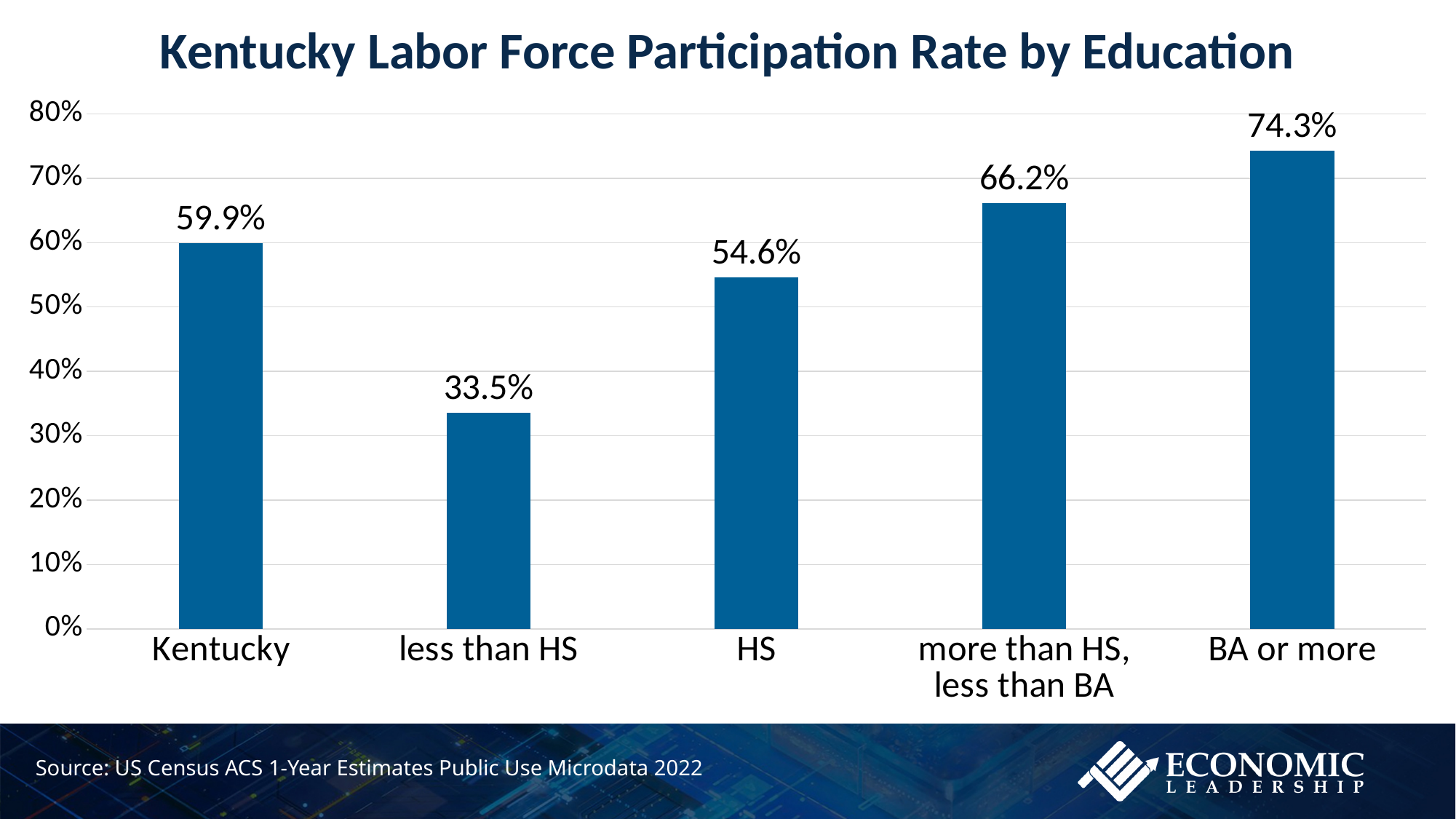
What is the labor force participation rate for those with less than HS education? 33.5% Which category has the lowest labor force participation rate? less than HS What is the labor force participation rate for BA or more? 74.3% What is the labor force participation rate for Kentucky overall? 59.9% What is the labor force participation rate for the HS category? 54.6% Which has a higher participation rate, HS or more than HS, less than BA? more than HS, less than BA What is the title of the chart? Kentucky Labor Force Participation Rate by Education How many categories are shown on the chart? 5 What is the difference between the Kentucky overall rate and the HS rate? 5.3% Which category has the highest labor force participation rate? BA or more What kind of chart is shown on the slide? Bar chart What is the difference in participation rate between BA or more and less than HS? 40.8%